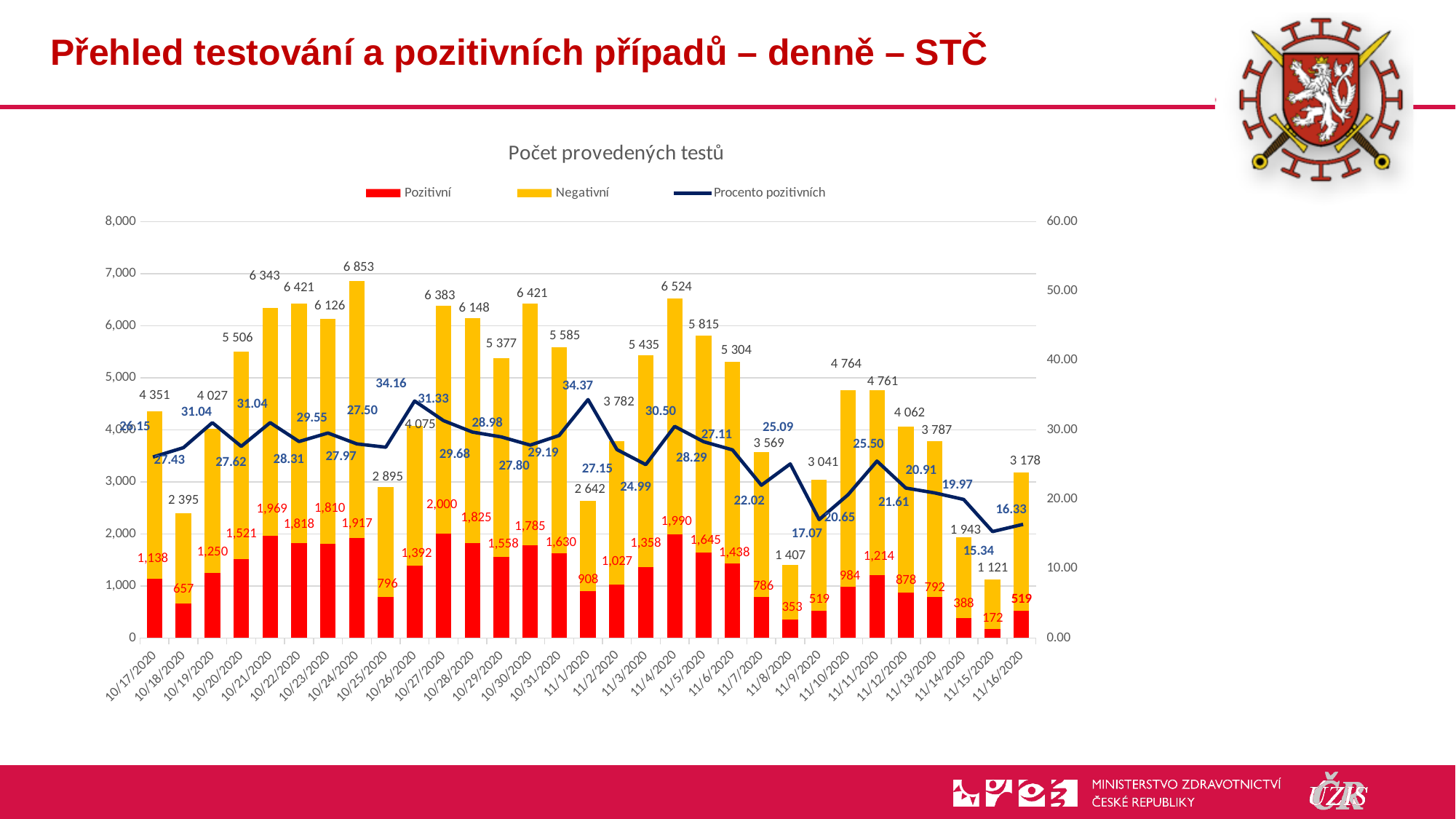
How many series does the legend list? 3 What kind of chart is shown on the slide? bar chart with a line What is the total number of tests labelled above the bar for 11/4/2020? 6 524 What is the Pozitivní value for 10/27/2020? 2,000 On which date is the total bar (tests performed) the highest? 10/24/2020 What is the difference between the Pozitivní values for 10/21/2020 and 10/22/2020? 151 How many dates are shown on the x axis? 31 What is the title of the chart? Počet provedených testů On which date is the total bar (tests performed) the lowest? 11/15/2020 What is the Procento pozitivních value for 11/1/2020? 34.37 On which date is the Procento pozitivních value the lowest? 11/15/2020 Which date has the larger total bar, 10/21/2020 or 10/22/2020? 10/22/2020